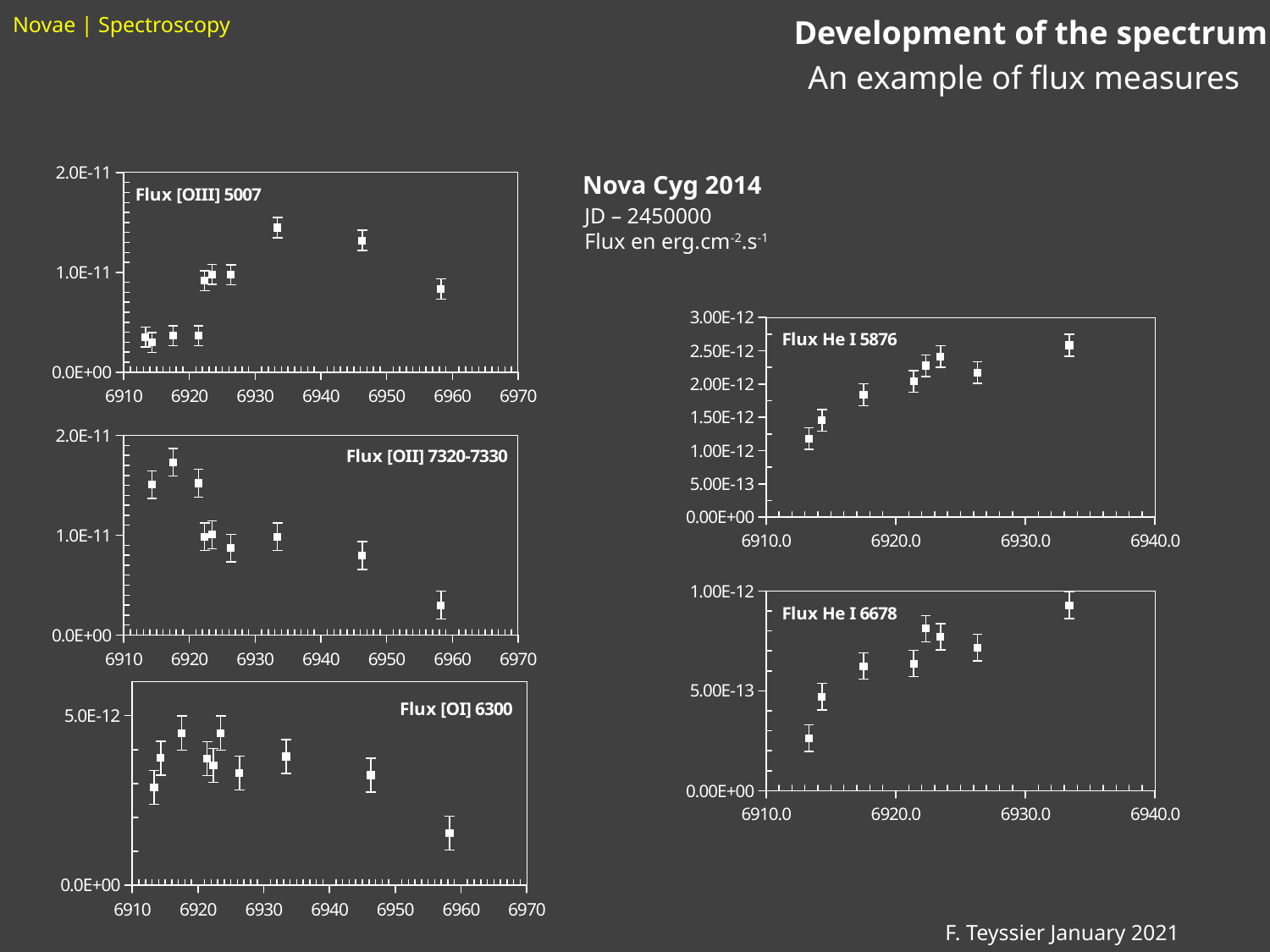
In the 'Flux He I 6678' chart, is the value of the point near 6913 greater or less than 5.00E-13? less In the 'Flux He I 6678' chart, do the values generally rise or fall from 6910 to 6935? rise In the 'Flux He I 5876' chart, is the value of the point near 6917 greater or less than 1.50E-12? greater What is the highest y-axis tick label on the 'Flux He I 5876' chart? 3.00E-12 In the 'Flux [OIII] 5007' chart, which point has the larger value: the one near 6933 or the one near 6958? the one near 6933 In the 'Flux [OII] 7320-7330' chart, is the value of the point near 6958 greater or less than 1.0E-11? less What kind of chart is the 'Flux He I 5876' chart? scatter chart How many charts are shown on the slide? 5 In the 'Flux [OII] 7320-7330' chart, do the values generally rise or fall from 6915 to 6960? fall